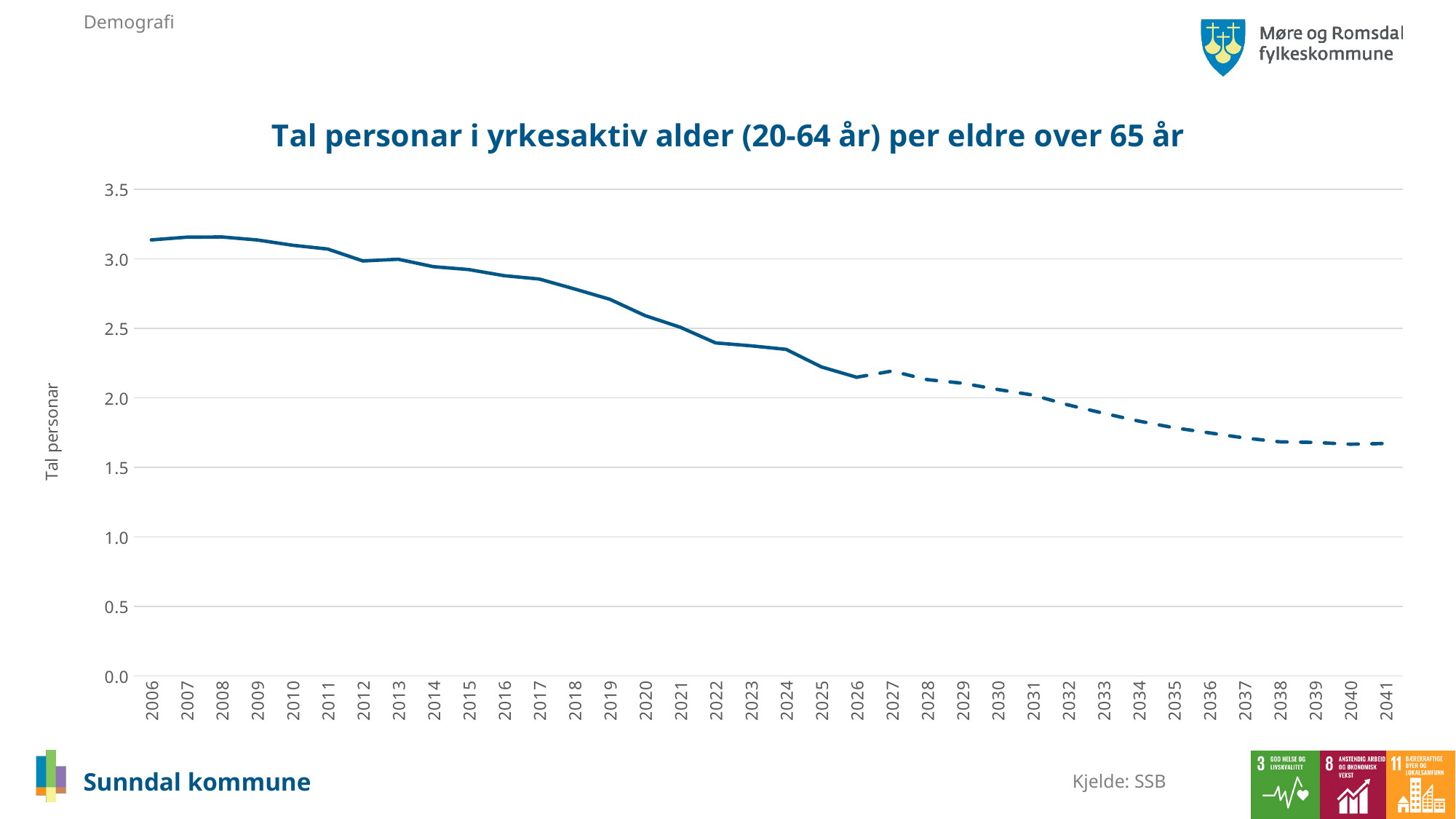
What is the label on the vertical axis of the chart? Tal personar What kind of chart is shown on the slide? line chart Which year has the larger value, 2006 or 2041? 2006 Is the value for 2041 greater or less than 2.0? less How many years are shown along the x axis of the chart? 36 Is the value for 2034 greater or less than 2.0? less Do the values rise or fall along the x axis from 2006 to 2041? fall Is the value for 2006 greater or less than 3.0? greater Which year has the larger value, 2013 or 2026? 2013 What is the title of the chart? Tal personar i yrkesaktiv alder (20-64 år) per eldre over 65 år